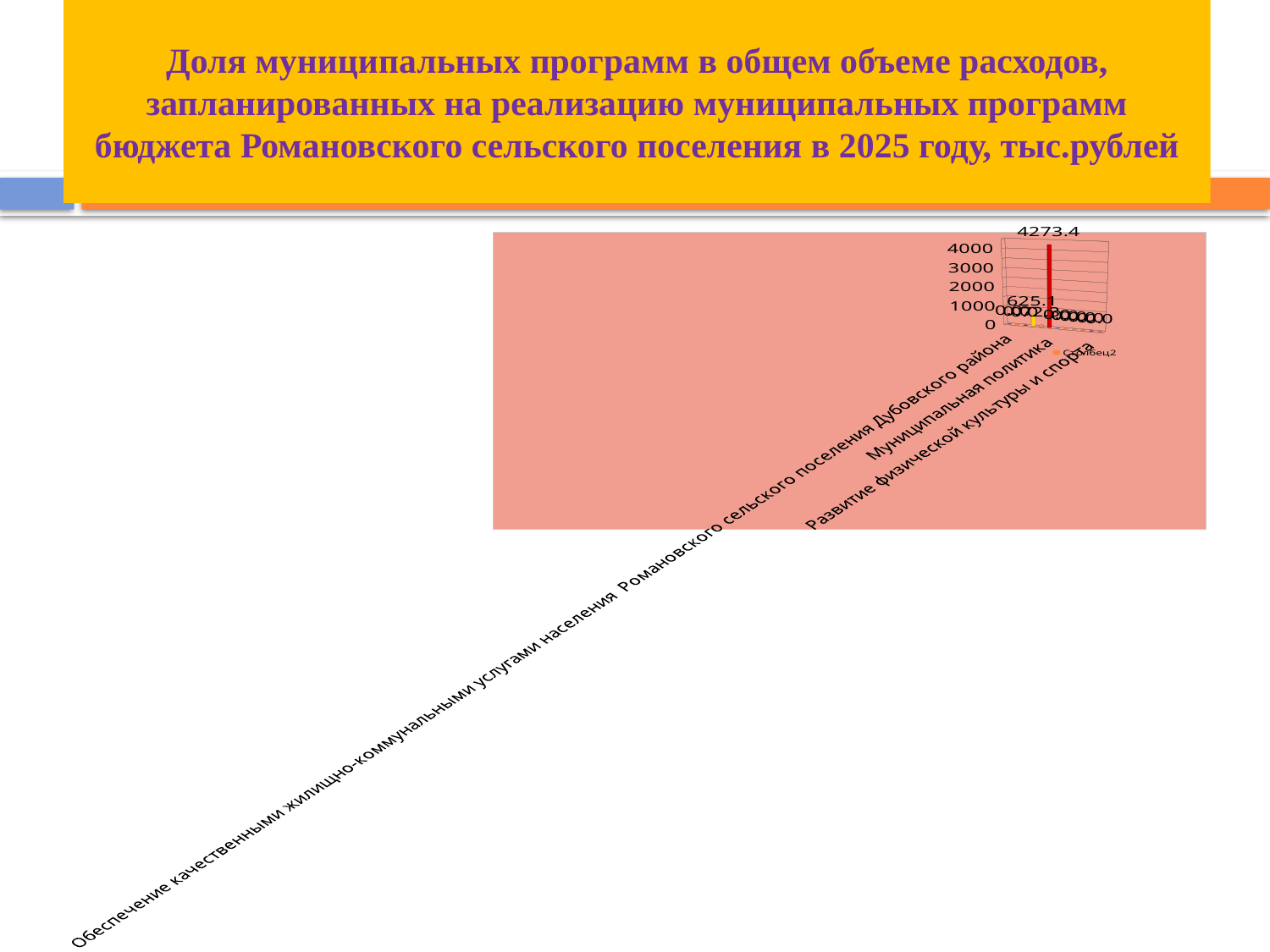
What is the second data label printed on the chart, next to the shorter yellow bar? 625.1 What entry does the chart legend list? Столбец2 What kind of chart is shown on the slide? bar chart Is the value of the yellow bar labelled 625.1 greater or less than 1000? less Is the value of the tallest (red) bar greater or less than 4000? greater How many series does the chart legend list? 1 Which labelled value is larger, 4273.4 or 625.1? 4273.4 What is the difference between the two labelled values 4273.4 and 625.1? 3648.3 What is the largest data label printed on the chart? 4273.4 What is the highest tick value shown on the vertical axis of the chart? 4000